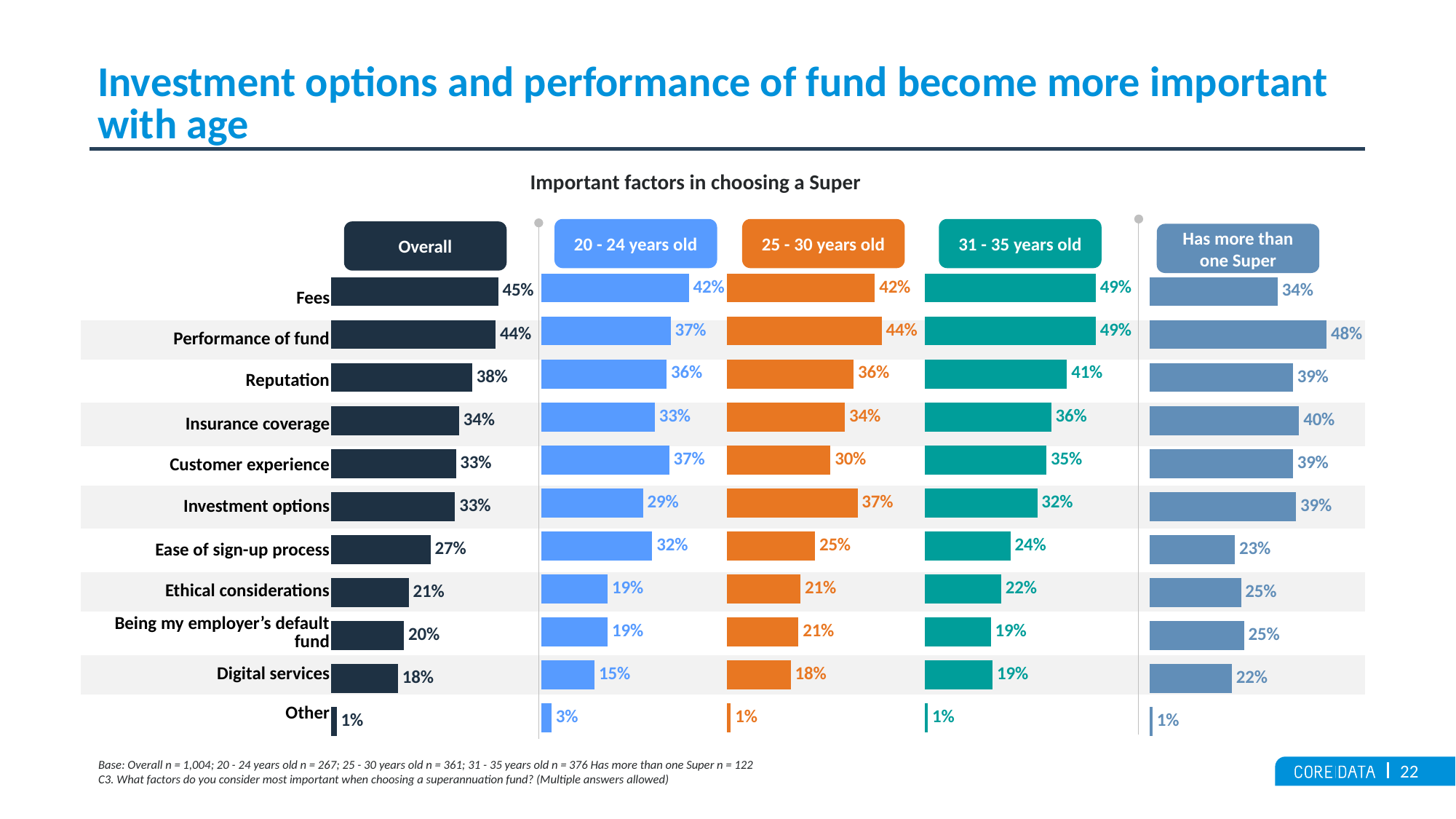
In the Overall chart, is the value for Ease of sign-up process greater or less than 30%? less In the Has more than one Super chart, which factor has the highest value? Performance of fund In the 20 - 24 years old chart, which is larger: Customer experience or Investment options? Customer experience What kind of chart is used for the Overall panel? bar chart In the 31 - 35 years old chart, what is the difference between Fees and Reputation? 8% In the 20 - 24 years old chart, which factor has the lowest value? Other In the Overall chart, what is the value for Fees? 45% How many factors are listed in the Overall chart? 11 In the Has more than one Super chart, what is the value for Performance of fund? 48% What is the title of the chart on the slide? Important factors in choosing a Super In the 25 - 30 years old chart, what is the difference between Performance of fund and Customer experience? 14% In the 25 - 30 years old chart, what is the value for Investment options? 37%